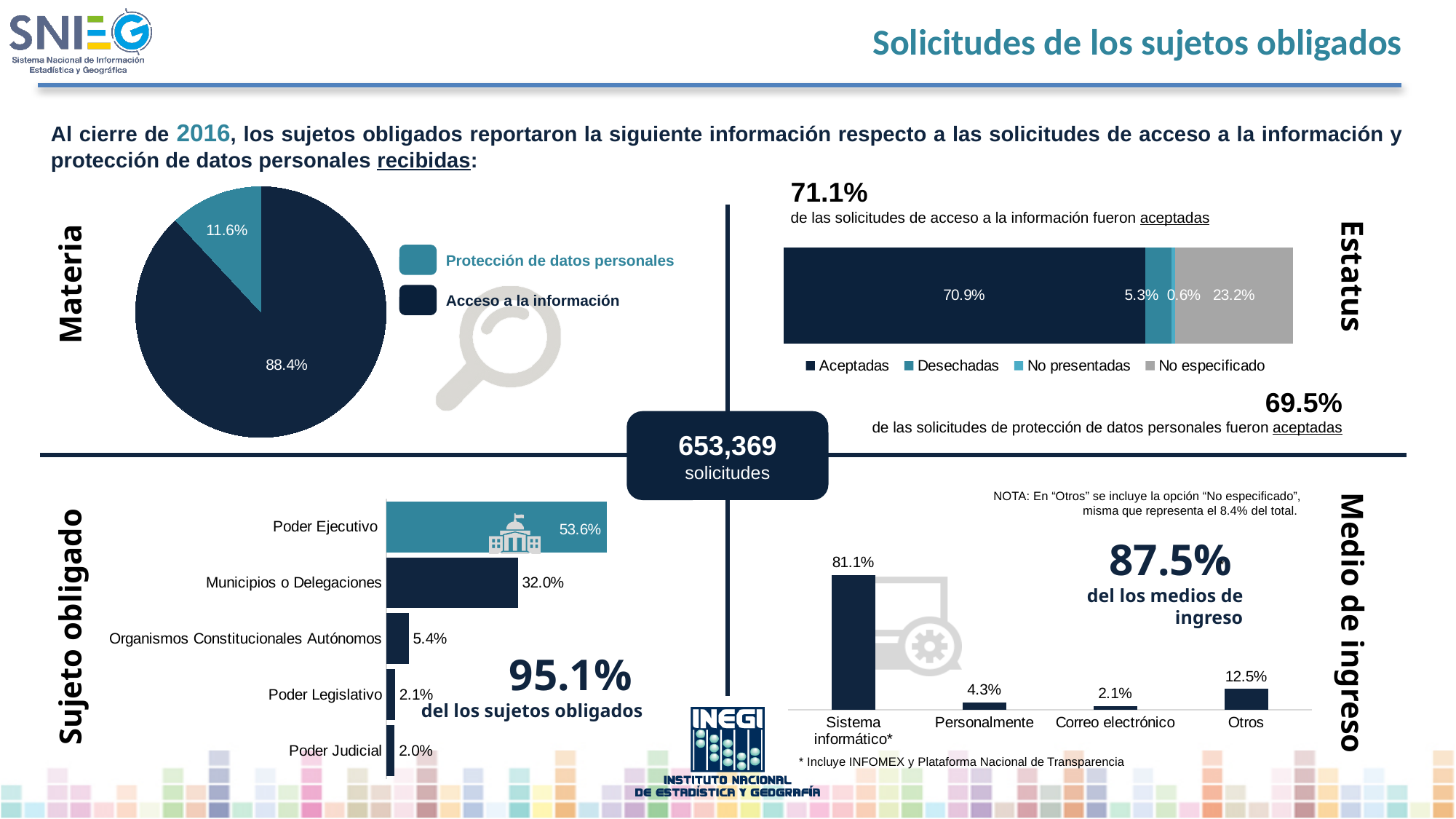
In the Medio de ingreso bar chart, which is larger, Personalmente or Otros? Otros In the Materia pie chart, what share is Protección de datos personales? 11.6% How many categories are shown in the Medio de ingreso bar chart? 4 In the Estatus stacked bar, which category has the smallest value? No presentadas In the Estatus stacked bar, what is the value for Desechadas? 5.3% How many series does the legend of the Estatus stacked bar list? 4 In the Estatus stacked bar, what is the value for No especificado? 23.2% In the Sujeto obligado bar chart, what is the value for Municipios o Delegaciones? 32.0% What kind of chart is the Materia chart? Pie chart In the Sujeto obligado bar chart, what is the difference between Poder Ejecutivo and Municipios o Delegaciones? 21.6% In the Materia pie chart, what share is Acceso a la información? 88.4% In the Sujeto obligado bar chart, which category has the highest value? Poder Ejecutivo